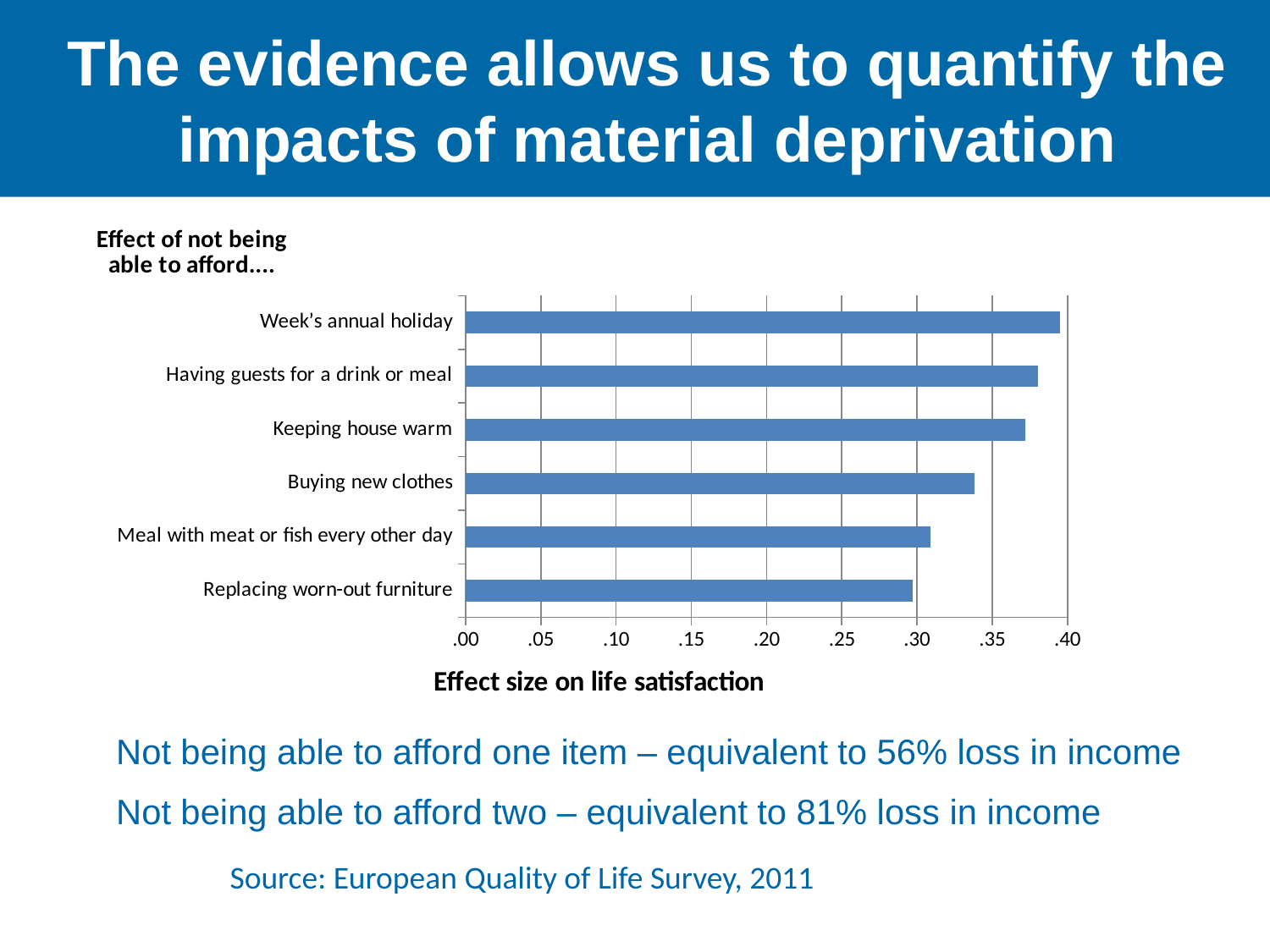
Which has a larger effect size: Buying new clothes or Meal with meat or fish every other day? Buying new clothes Do the bar lengths increase or decrease going from the top item to the bottom item? decrease Is the effect size for Keeping house warm greater or less than .35? greater Is the effect size for Replacing worn-out furniture greater or less than .25? greater Which item has the largest effect size on life satisfaction? Week's annual holiday Is the effect size for Buying new clothes greater or less than .30? greater Which item has the smallest effect size on life satisfaction? Replacing worn-out furniture What kind of chart is shown on the slide? bar chart How many categories (items) are plotted in the chart? 6 Which has a larger effect size: Week's annual holiday or Replacing worn-out furniture? Week's annual holiday What is the title of the horizontal axis of the chart? Effect size on life satisfaction